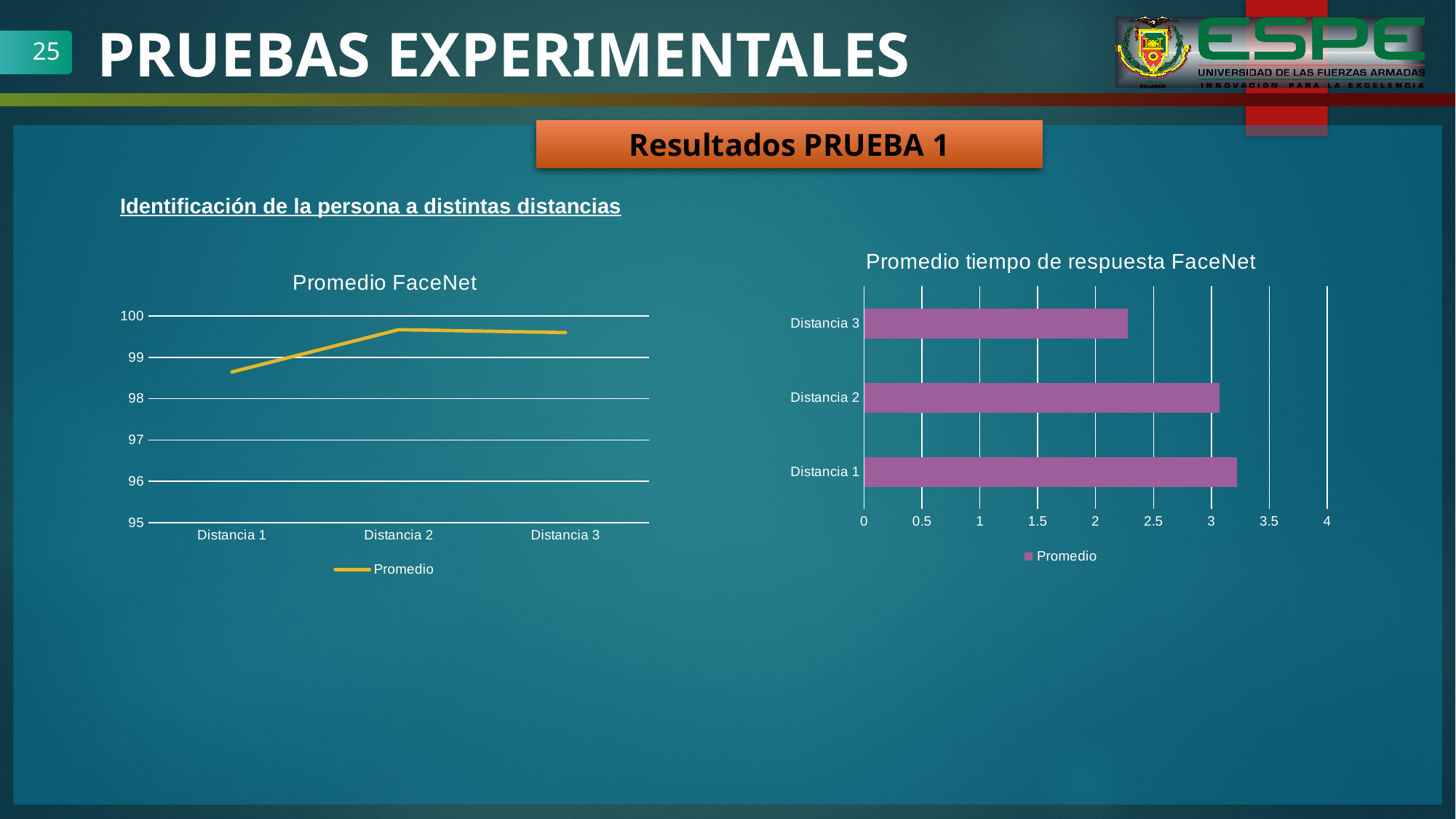
In the 'Promedio FaceNet' chart, how many categories are shown on the x axis? 3 In the 'Promedio FaceNet' chart, is the value for Distancia 2 greater or less than 99? greater In the 'Promedio FaceNet' chart, is the value for Distancia 1 greater or less than 99? less What kind of chart is the 'Promedio tiempo de respuesta FaceNet' chart on the right? bar chart In the 'Promedio FaceNet' chart, does the value rise or fall from Distancia 1 to Distancia 2? rises In the 'Promedio FaceNet' chart, which category has the lowest value? Distancia 1 In the 'Promedio tiempo de respuesta FaceNet' chart, is the value for Distancia 1 greater or less than 3? greater In the 'Promedio tiempo de respuesta FaceNet' chart, which category has the lowest value? Distancia 3 In the 'Promedio tiempo de respuesta FaceNet' chart, how many series does the legend list? 1 In the 'Promedio tiempo de respuesta FaceNet' chart, which is larger, the value for Distancia 1 or Distancia 3? Distancia 1 What kind of chart is the 'Promedio FaceNet' chart on the left? line chart